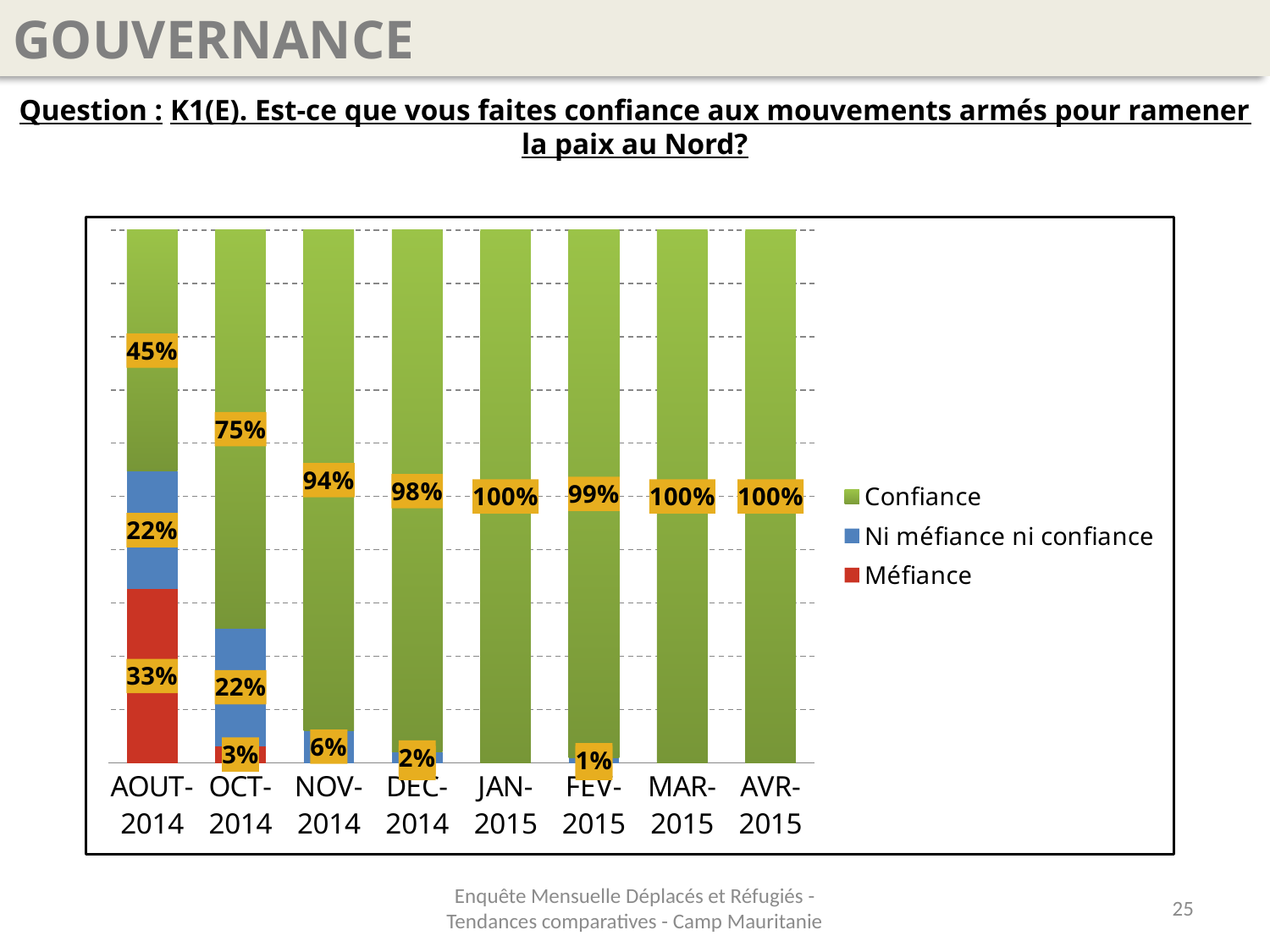
Does the Confiance value generally rise or fall from AOUT-2014 to AVR-2015? Rise How many series does the legend list? 3 What is the Confiance value for AOUT-2014? 45% Which month has the lowest Confiance value? AOUT-2014 What is the difference between the Confiance values for OCT-2014 and AOUT-2014? 30% Is the Confiance value higher in DEC-2014 or in NOV-2014? DEC-2014 What is the Confiance value for OCT-2014? 75% What is the Méfiance value for AOUT-2014? 33% How many months are shown on the x axis? 8 What is the Méfiance value for OCT-2014? 3% What is the Confiance value for NOV-2014? 94% What type of chart is shown on the slide? Stacked bar chart